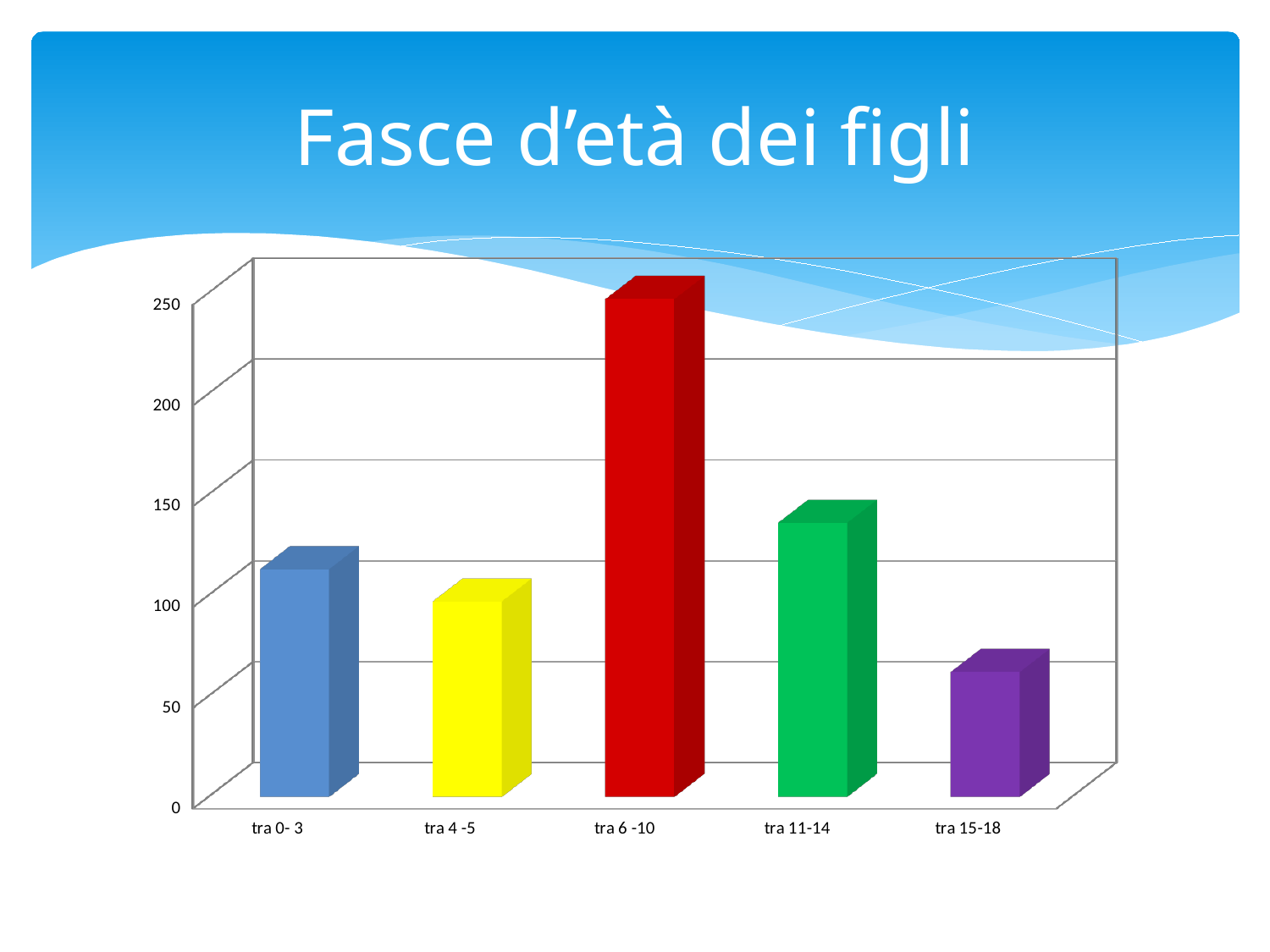
What colour is the bar for tra 6 -10? red Is the value for tra 0- 3 greater or less than 150? less What is the title of the chart? Fasce d'età dei figli Which age category has the highest bar? tra 6 -10 Which is larger, the value for tra 11-14 or the value for tra 0- 3? tra 11-14 Is the value for tra 15-18 greater or less than 100? less Is the value for tra 15-18 greater or less than 50? greater Which age category has the lowest bar? tra 15-18 What kind of chart is shown on the slide? bar chart How many age categories are shown on the x axis? 5